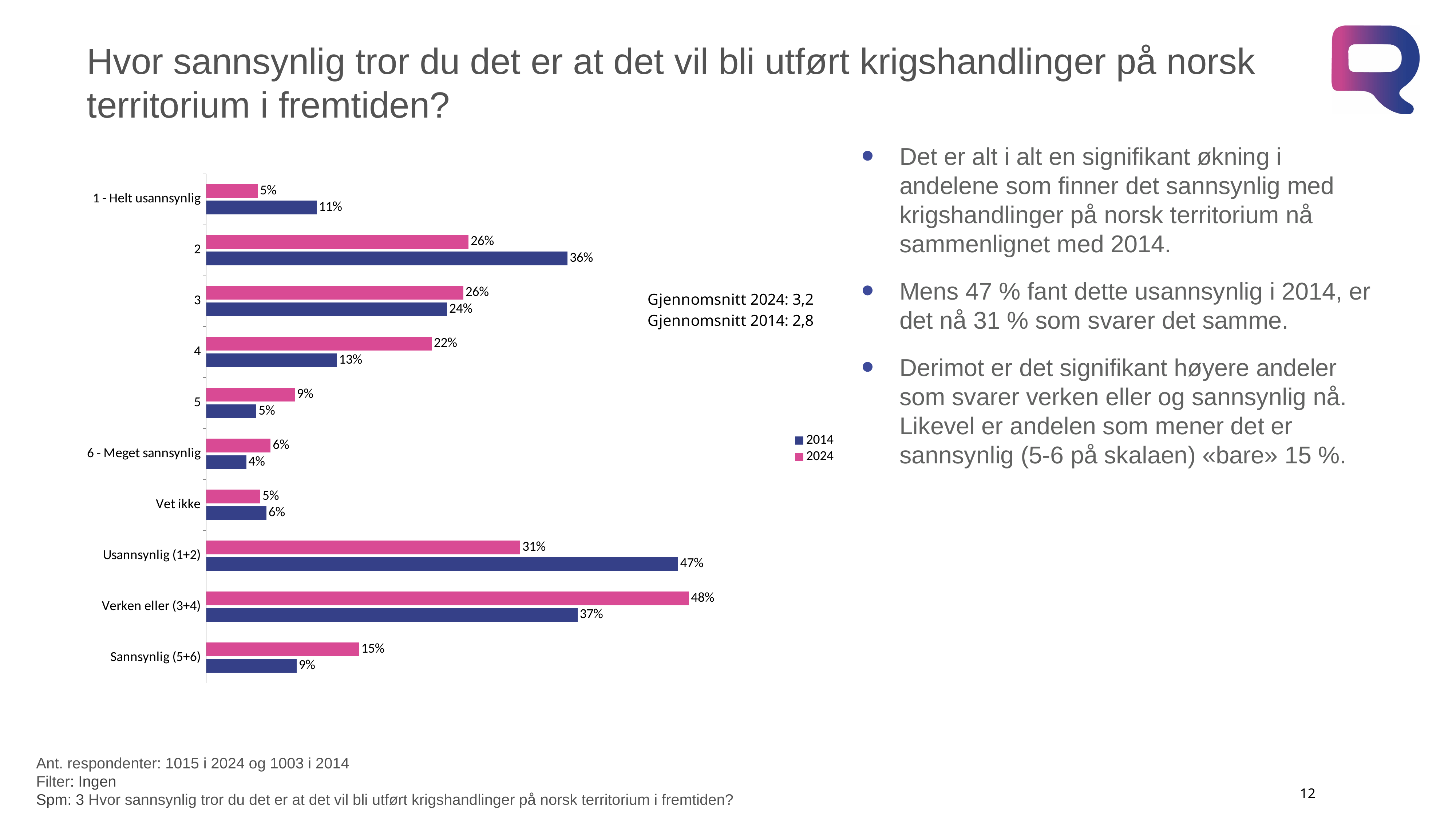
What is the 2014 value for "Sannsynlig (5+6)"? 9% Which category has the highest 2014 value? Usannsynlig (1+2) What is the 2024 value for "Verken eller (3+4)"? 48% What is the 2024 value for "1 - Helt usannsynlig"? 5% How many series does the legend list? 2 Which category has the lowest 2014 value? 6 - Meget sannsynlig What is the 2014 value for "2"? 36% What is the difference between the 2014 and 2024 values for "Usannsynlig (1+2)"? 16% How many categories are shown on the chart? 10 Which is larger for "4": the 2014 value or the 2024 value? 2024 Which colour represents the 2024 series in the chart? Pink What kind of chart is shown on the slide? Bar chart